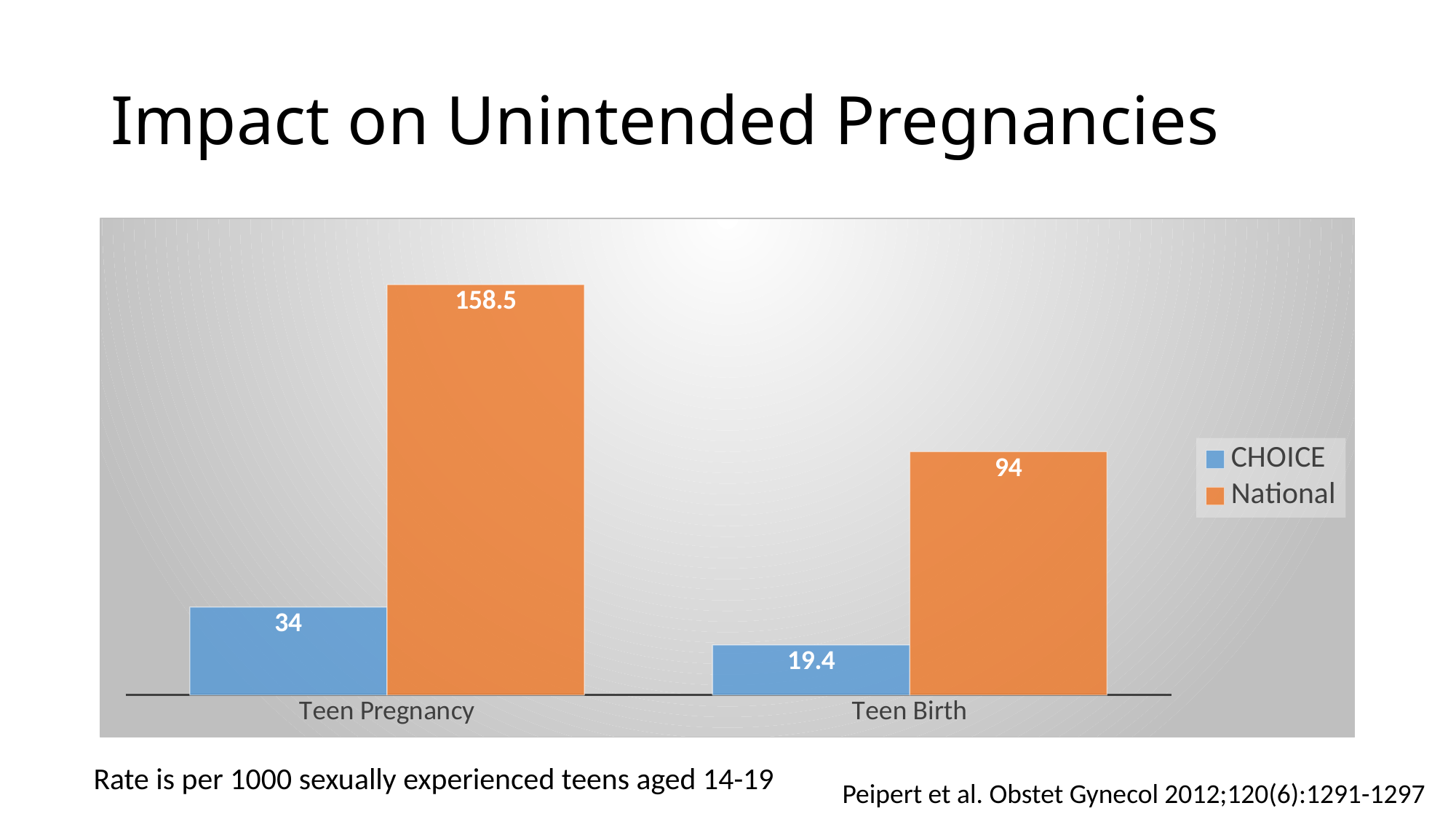
What is the National value for Teen Pregnancy? 158.5 Which bar has the highest value on the chart? National, Teen Pregnancy How many series does the legend list? 2 What is the National value for Teen Birth? 94 How many categories are shown on the x axis? 2 What is the CHOICE value for Teen Pregnancy? 34 What is the difference between the National and CHOICE values for Teen Pregnancy? 124.5 Which is larger for Teen Birth, the CHOICE value or the National value? National What is the CHOICE value for Teen Birth? 19.4 What is the difference between the National and CHOICE values for Teen Birth? 74.6 Which bar has the lowest value on the chart? CHOICE, Teen Birth What kind of chart is shown on the slide? Bar chart